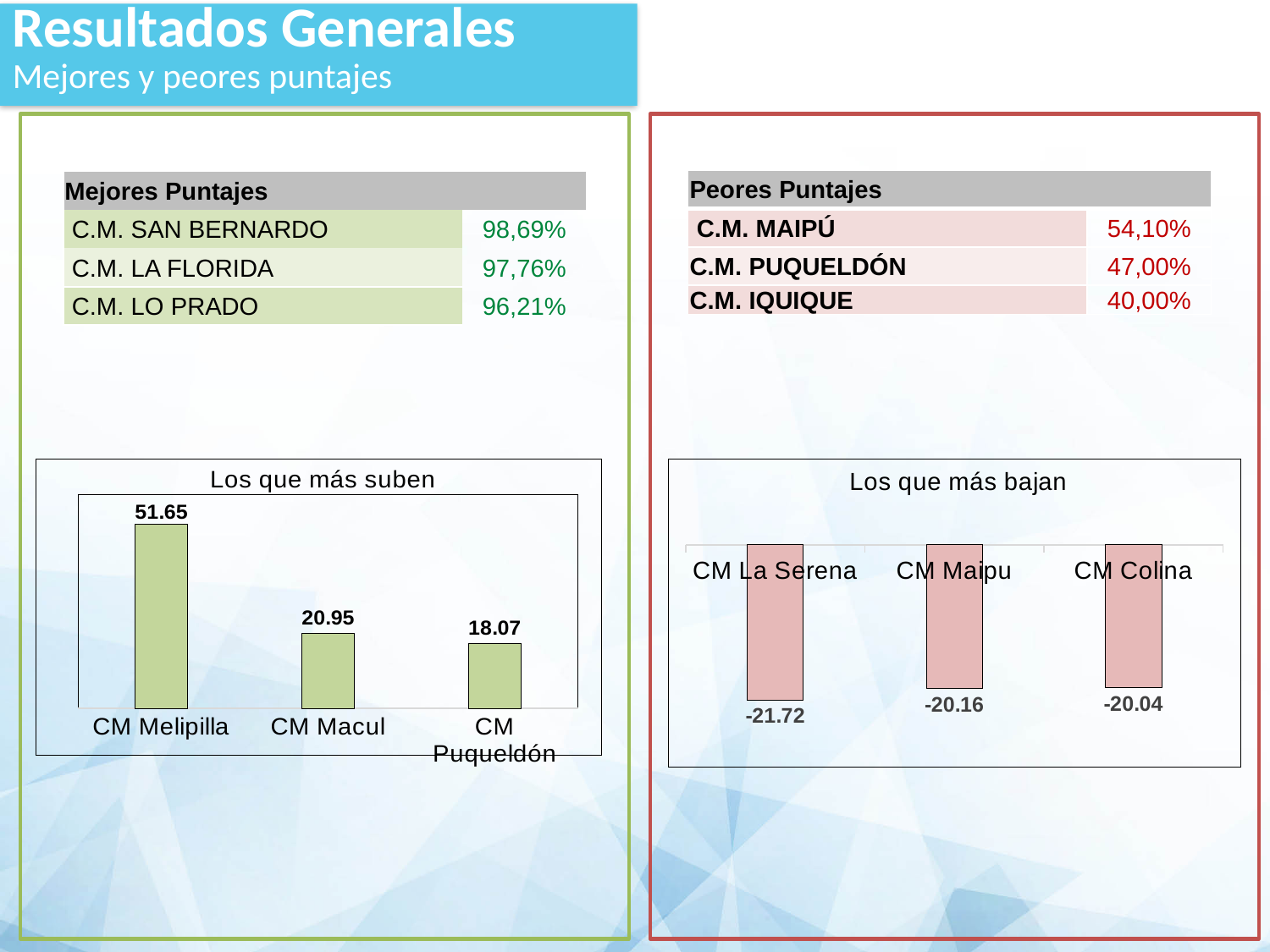
What kind of chart is 'Los que más bajan'? Bar chart In the 'Los que más suben' chart, which category has the highest value? CM Melipilla In the 'Los que más bajan' chart, what is the value for CM La Serena? -21.72 In the 'Los que más suben' chart, do the values rise or fall from left to right? Fall In the 'Los que más suben' chart, what is the value for CM Melipilla? 51.65 In the 'Los que más suben' chart, what is the difference between the values for CM Melipilla and CM Macul? 30.70 In the 'Los que más suben' chart, how many categories are plotted? 3 In the 'Los que más bajan' chart, what is the value for CM Colina? -20.04 In the 'Los que más suben' chart, what is the value for CM Macul? 20.95 In the 'Los que más bajan' chart, which category has the lowest value? CM La Serena In the 'Los que más bajan' chart, what is the value for CM Maipu? -20.16 In the 'Los que más suben' chart, what is the value for CM Puqueldón? 18.07